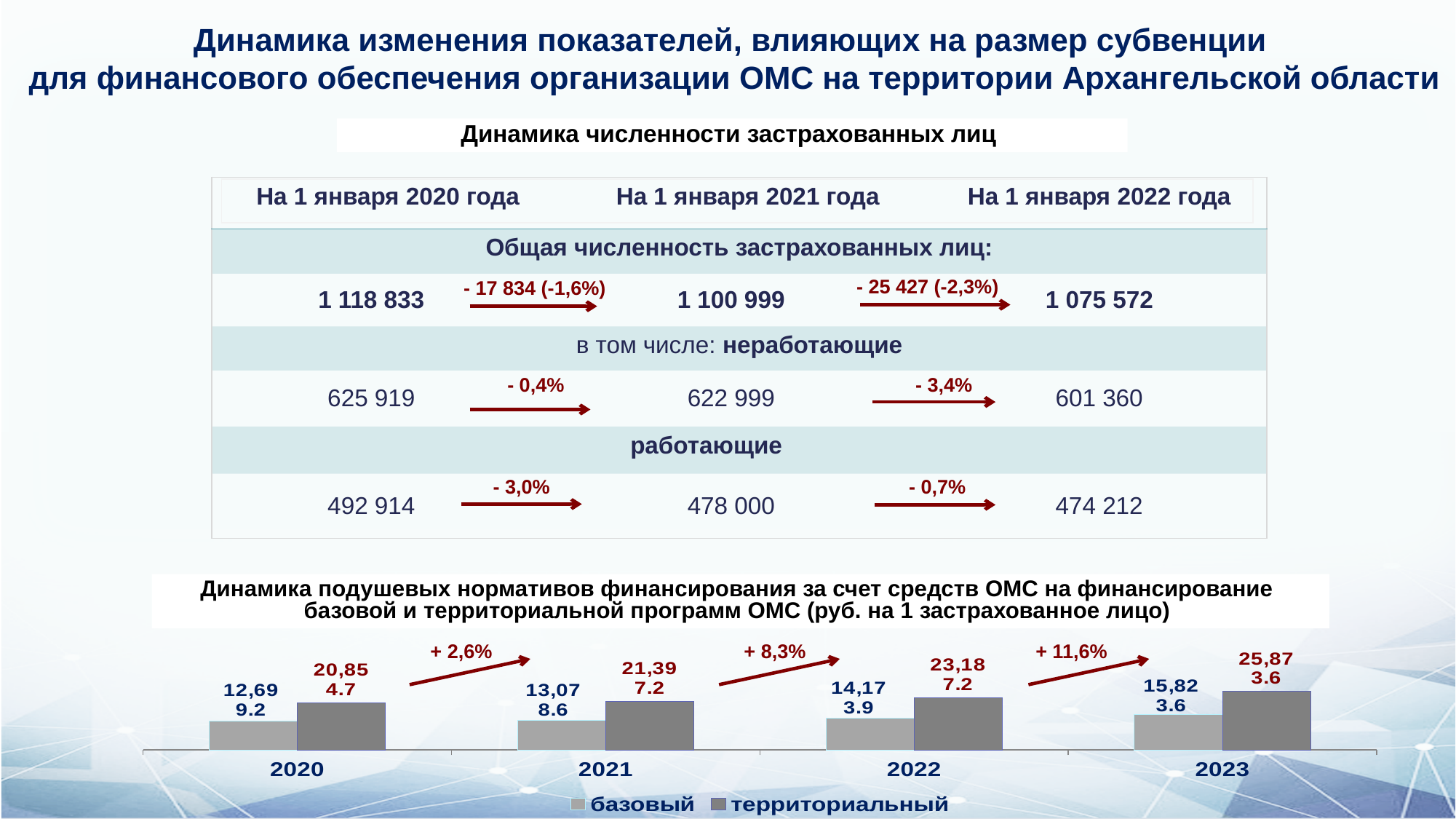
How many years are shown on the x axis of the bar chart? 4 In the bar chart, what percentage change is shown between 2020 and 2021? + 2,6% In the bar chart, which year has the lowest базовый value? 2020 In the bar chart, what percentage change is shown between 2021 and 2022? + 8,3% How many series does the legend of the bar chart list? 2 In the bar chart, what percentage change is shown between 2022 and 2023? + 11,6% What are the two legend entries of the bar chart? базовый, территориальный In the bar chart, which series has the larger value in 2023, базовый or территориальный? территориальный What kind of chart is shown at the bottom of the slide? bar chart In the bar chart, which year has the highest территориальный value? 2023 In the bar chart, do the территориальный values rise or fall from 2020 to 2023? rise In the bar chart, which year has the largest percentage increase annotation? 2023